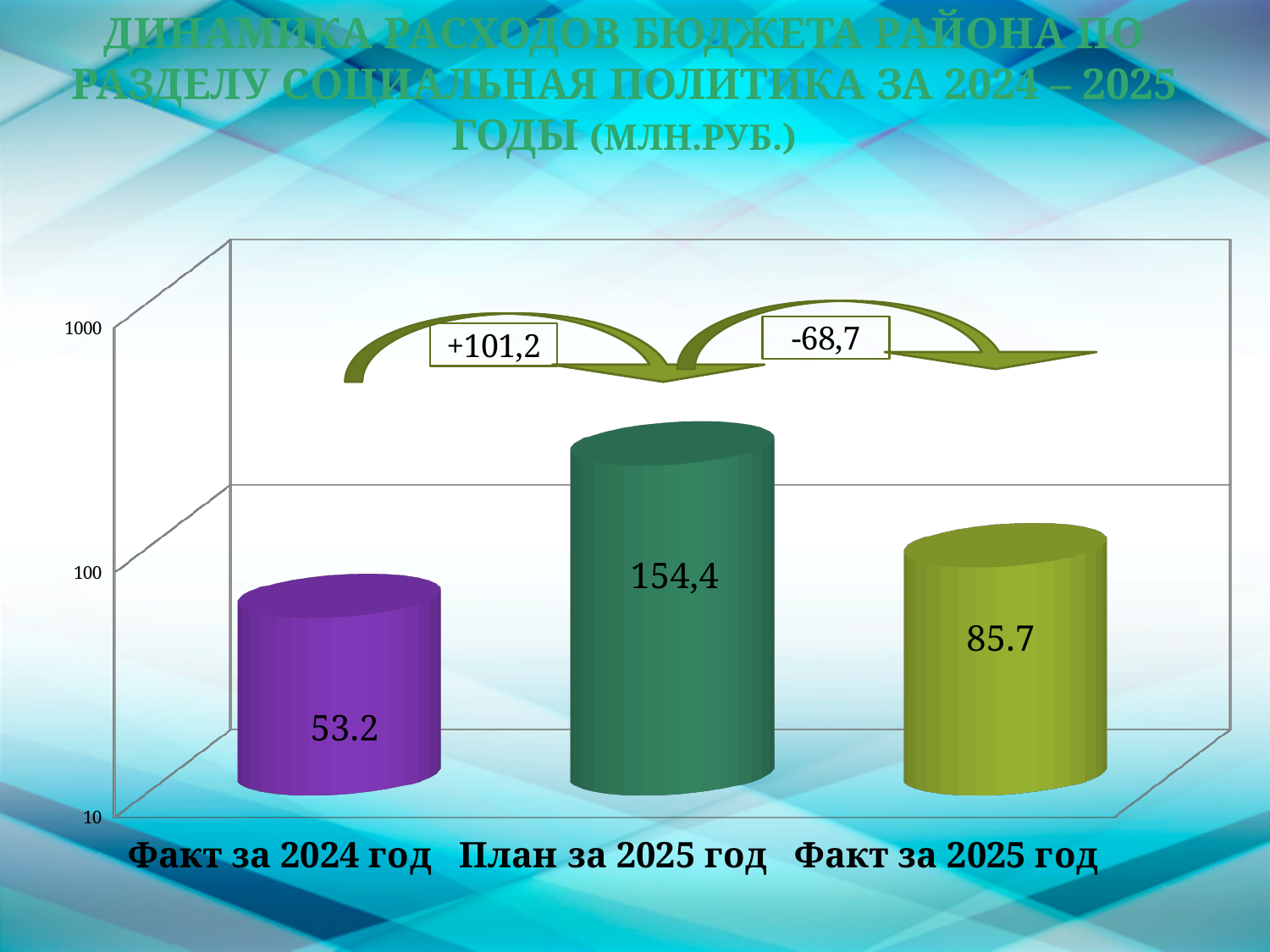
What unit of measurement is given in the chart title? млн.руб. What kind of chart is shown on the slide? bar chart Is the value for Факт за 2024 год greater or less than 100? less What is the difference between План за 2025 год and Факт за 2024 год? 101,2 Which category has the highest value? План за 2025 год Which is larger, Факт за 2025 год or Факт за 2024 год? Факт за 2025 год What is the value for Факт за 2024 год? 53.2 What is the difference between План за 2025 год and Факт за 2025 год? 68,7 What is the value for План за 2025 год? 154,4 What is the value for Факт за 2025 год? 85.7 Which category has the lowest value? Факт за 2024 год How many categories are shown on the chart? 3